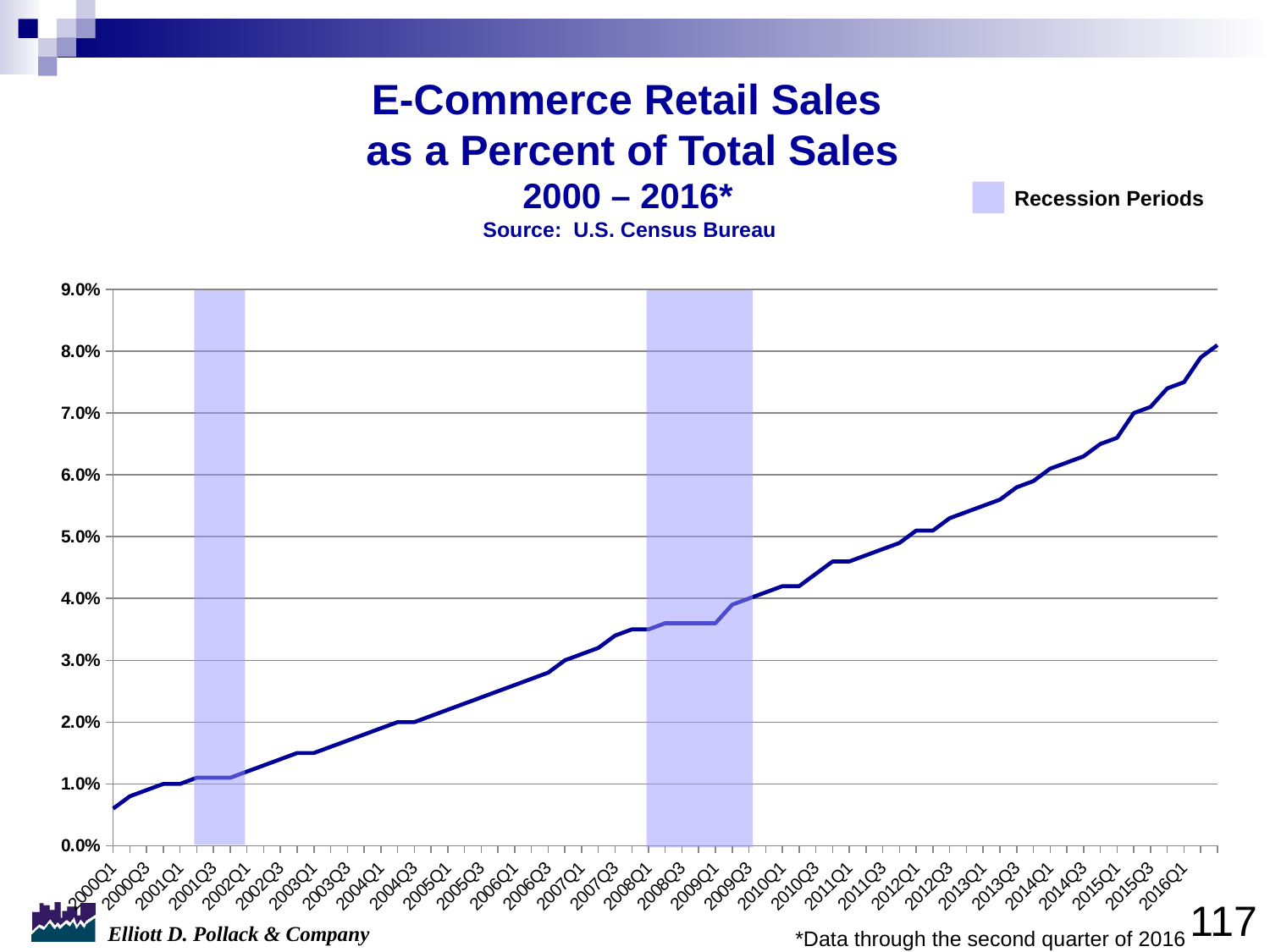
Is the value for 2005Q1 greater or less than 2.0%? greater Is the value for 2006Q1 greater or less than 3.0%? less Do the values generally rise or fall from 2000Q1 to 2016Q1? rise What kind of chart is shown on the slide? line chart What is the source of the data cited on the slide? U.S. Census Bureau Is the value for 2010Q1 greater or less than 4.0%? greater Which quarter has the lowest value on the chart? 2000Q1 What do the shaded vertical bands on the chart represent? Recession Periods